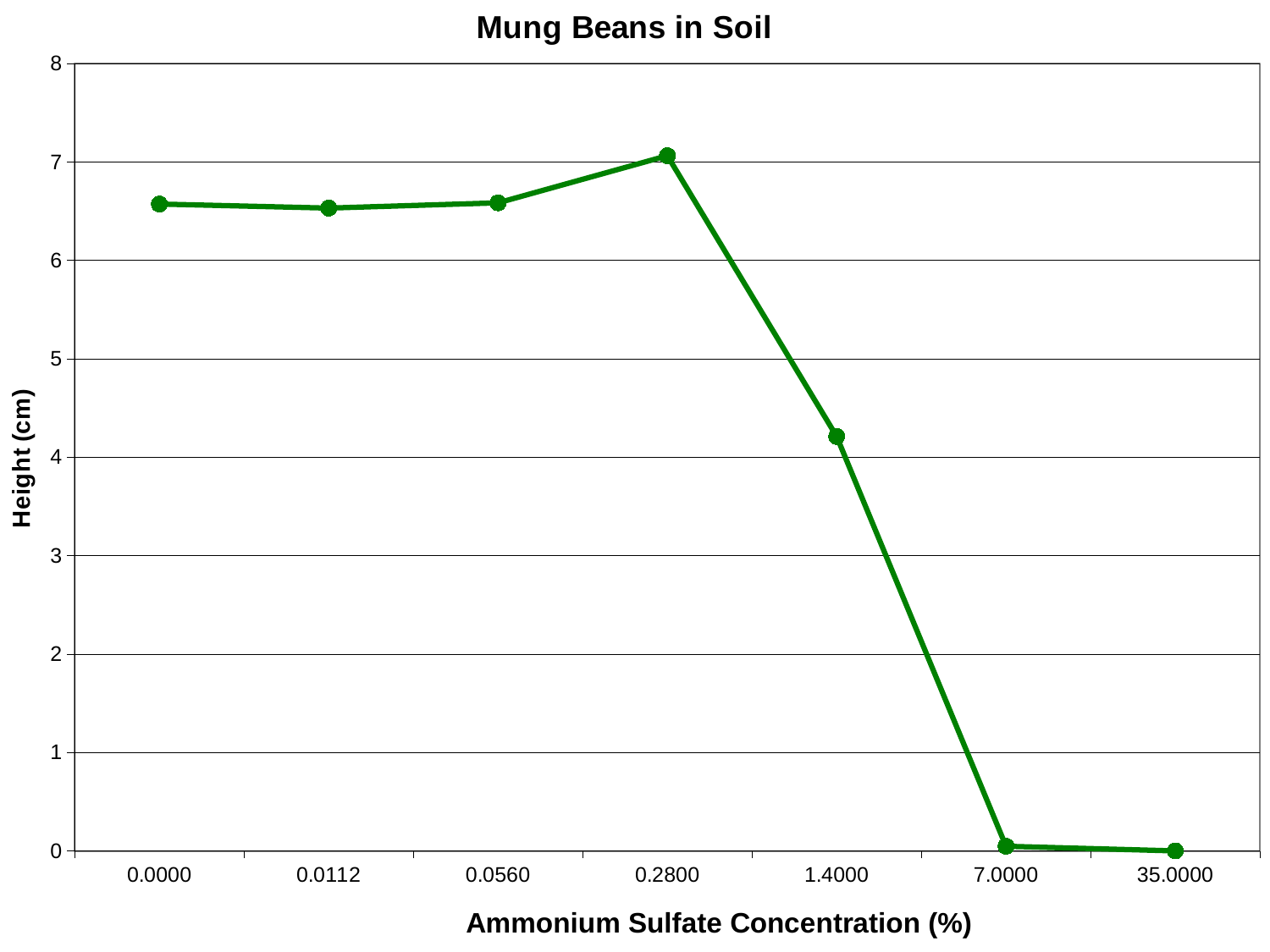
Is the height at 7.0000% ammonium sulfate greater or less than 1 cm? less How many data points are plotted on the line? 7 What kind of chart is shown on the slide? line chart At which ammonium sulfate concentration is the height highest? 0.2800 Is the height at 0.0000% ammonium sulfate greater or less than 6 cm? greater What is the label of the y axis? Height (cm) Is the height at 1.4000% ammonium sulfate greater or less than 5 cm? less What is the title of the chart? Mung Beans in Soil Does the height rise or fall between 0.2800% and 7.0000% ammonium sulfate? fall At which ammonium sulfate concentration is the height lowest? 35.0000 Which has the greater height: 0.2800% or 1.4000% ammonium sulfate? 0.2800